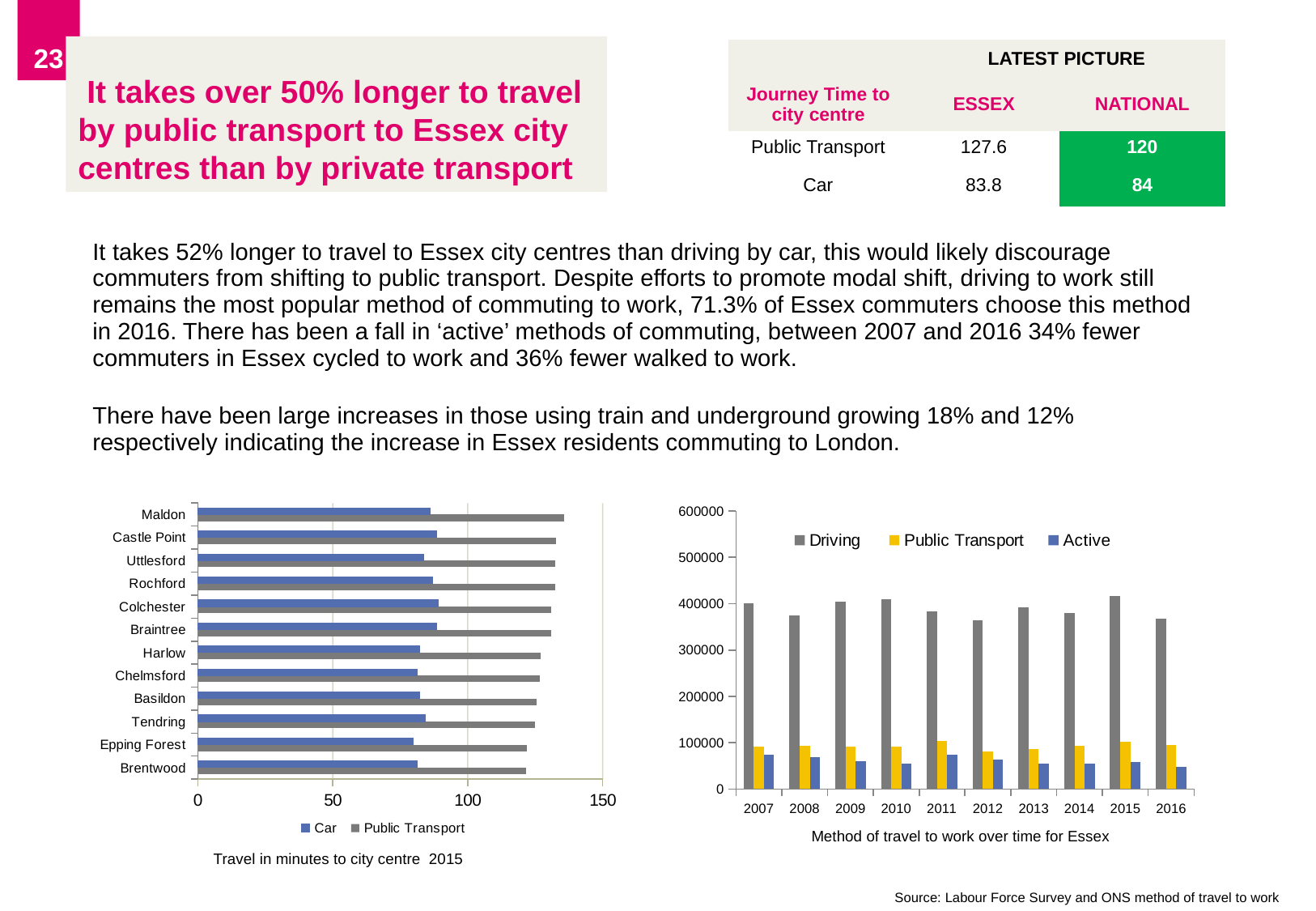
In the 'Method of travel to work over time for Essex' chart, which is larger in 2011, Public Transport or Active? Public Transport In the 'Travel in minutes to city centre 2015' chart, which is larger for Chelmsford, Car or Public Transport? Public Transport In the 'Method of travel to work over time for Essex' chart, is the Driving value for 2007 greater or less than 300000? greater In the 'Method of travel to work over time for Essex' chart, is the Active value for 2016 greater or less than 100000? less How many series does the legend list in the 'Method of travel to work over time for Essex' chart? 3 How many districts are shown in the 'Travel in minutes to city centre 2015' chart? 12 What kind of chart is the 'Travel in minutes to city centre 2015' chart on the left? bar chart In the 'Travel in minutes to city centre 2015' chart, which district has the highest Public Transport value? Maldon In the 'Travel in minutes to city centre 2015' chart, is the Public Transport value for Maldon greater or less than 100? greater How many series does the legend list in the 'Travel in minutes to city centre 2015' chart? 2 How many years are shown on the x axis of the 'Method of travel to work over time for Essex' chart? 10